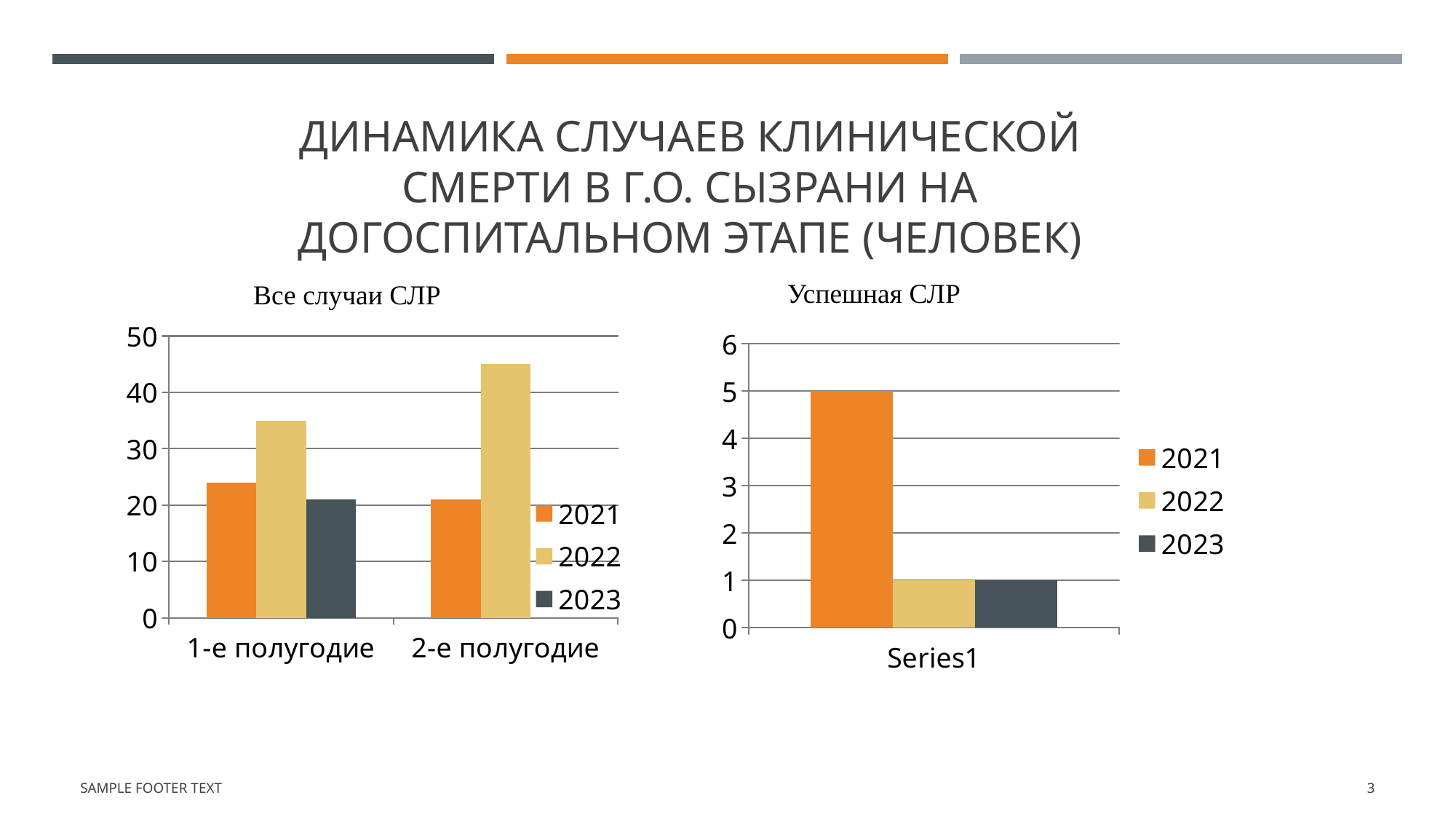
In the chart titled "Все случаи СЛР", which series has the highest bar in 2-е полугодие? 2022 In the chart titled "Успешная СЛР", what is the difference between the values for 2021 and 2023? 4 In the chart titled "Все случаи СЛР", is the value for 2021 in 1-е полугодие greater or less than 30? less In the chart titled "Все случаи СЛР", is the value for 2022 in 2-е полугодие greater or less than 40? greater In the chart titled "Все случаи СЛР", how many categories are shown on the x axis? 2 In the chart titled "Успешная СЛР", what is the value for 2022? 1 In the chart titled "Все случаи СЛР", which colour represents the 2021 series? orange In the chart titled "Успешная СЛР", how many series does the legend list? 3 What kind of chart is the chart titled "Все случаи СЛР"? bar chart In the chart titled "Успешная СЛР", what is the value for 2021? 5 In the chart titled "Все случаи СЛР", which is larger in 1-е полугодие: the value for 2021 or the value for 2022? 2022 In the chart titled "Успешная СЛР", which year has the highest value? 2021